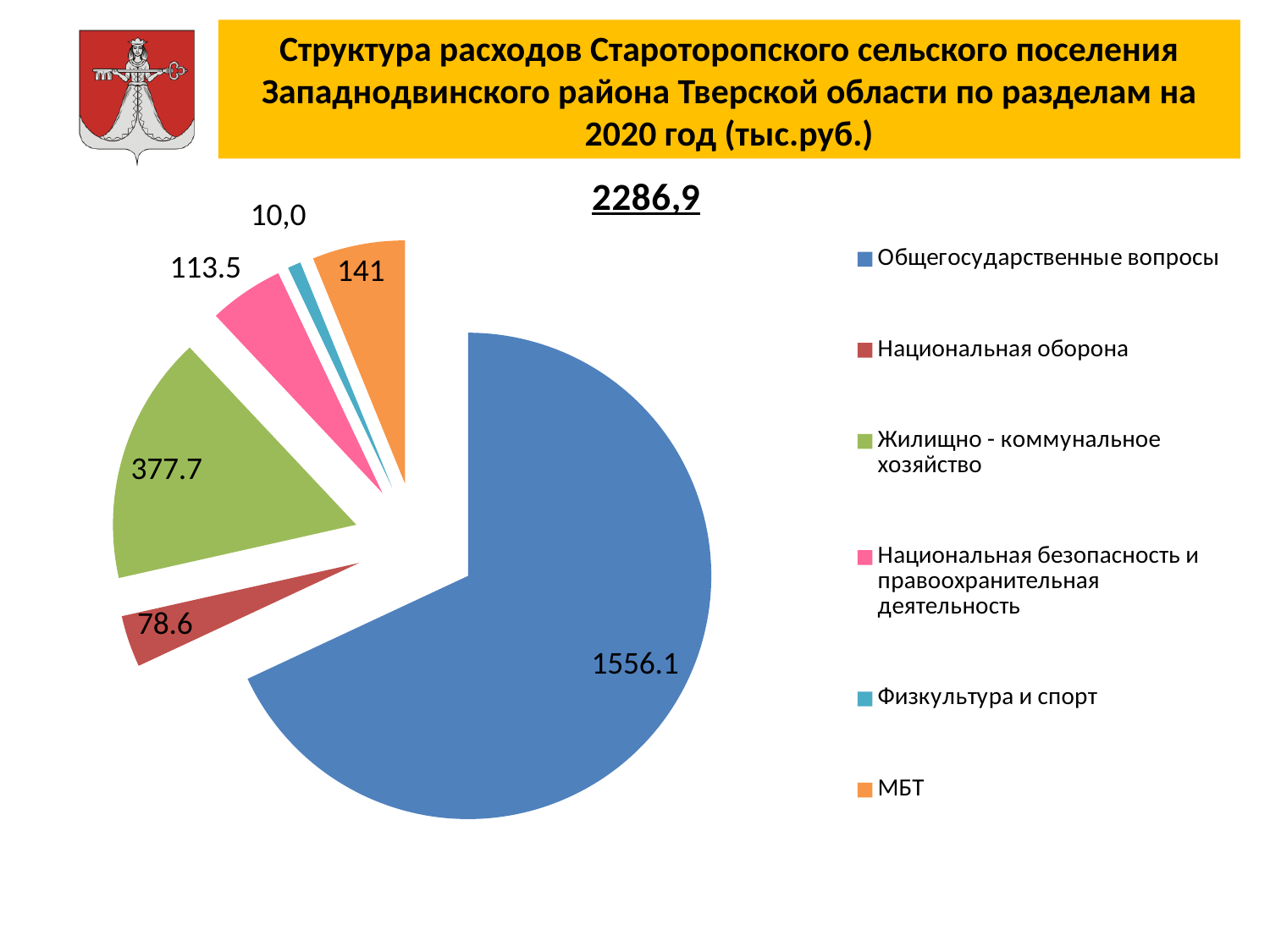
What is the value for Жилищно - коммунальное хозяйство? 377.7 What is the difference between МБТ and Национальная безопасность и правоохранительная деятельность? 27.5 What is the value for Общегосударственные вопросы? 1556.1 Which category has the smallest slice? Физкультура и спорт Which category has the largest slice? Общегосударственные вопросы What kind of chart is shown on the slide? pie chart What is the value for МБТ? 141 What is the value for Физкультура и спорт? 10,0 What is the value for Национальная оборона? 78.6 How many categories does the pie chart show? 6 Which is larger, Жилищно - коммунальное хозяйство or МБТ? Жилищно - коммунальное хозяйство What is the difference between Общегосударственные вопросы and Жилищно - коммунальное хозяйство? 1178.4